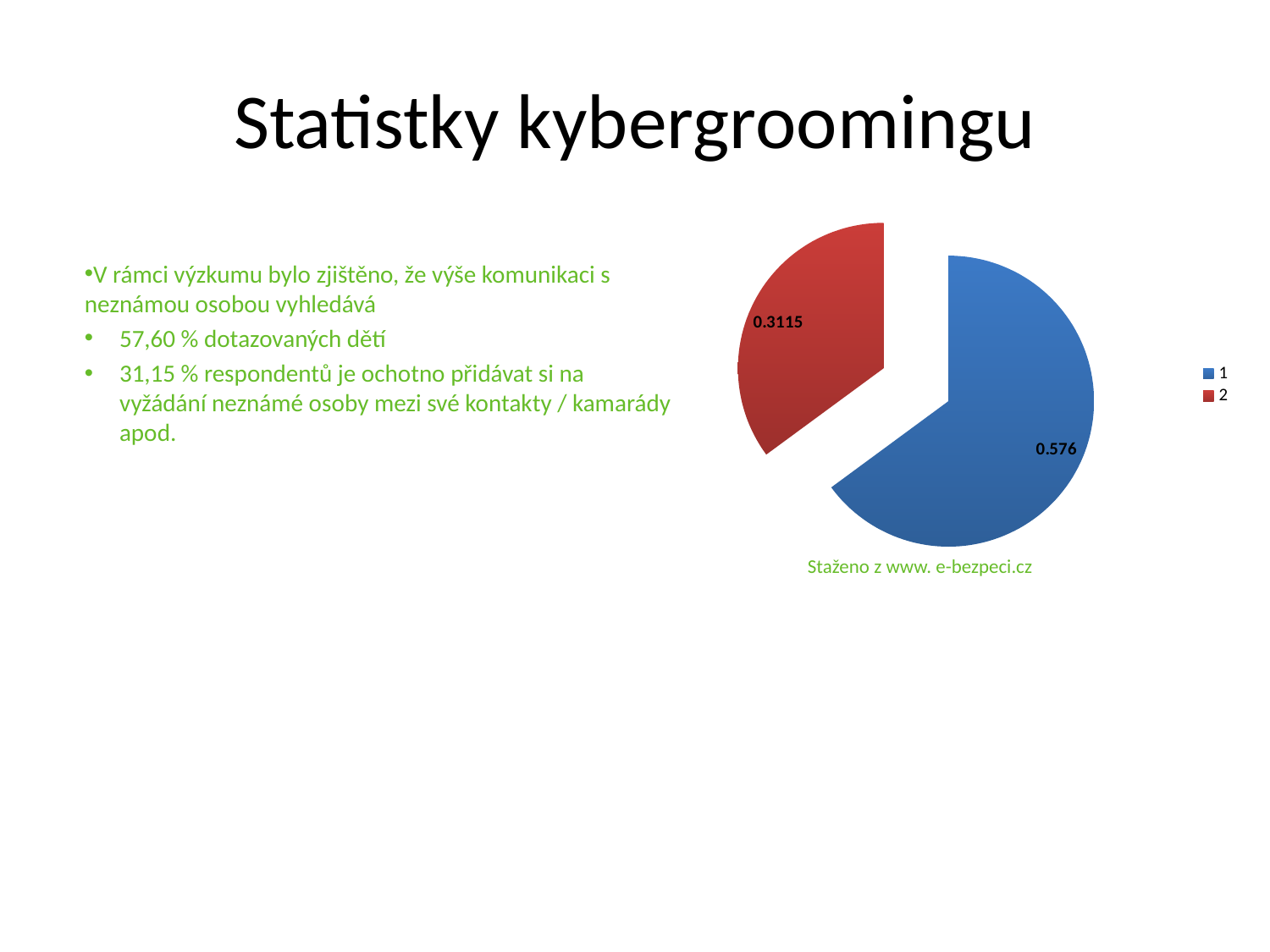
Which slice of the pie chart has the smallest value? 2 What is the difference between the values of slice 1 and slice 2 in the pie chart? 0.2645 What type of chart is shown on the slide? pie chart Which slice of the pie chart has the largest value? 1 What colour is slice 1 in the pie chart? blue What is the value shown for slice 2 in the pie chart? 0.3115 How many slices does the pie chart have? 2 What colour is slice 2 in the pie chart? red What is the value shown for slice 1 in the pie chart? 0.576 Which is larger in the pie chart, slice 1 or slice 2? 1 How many entries does the legend of the pie chart list? 2